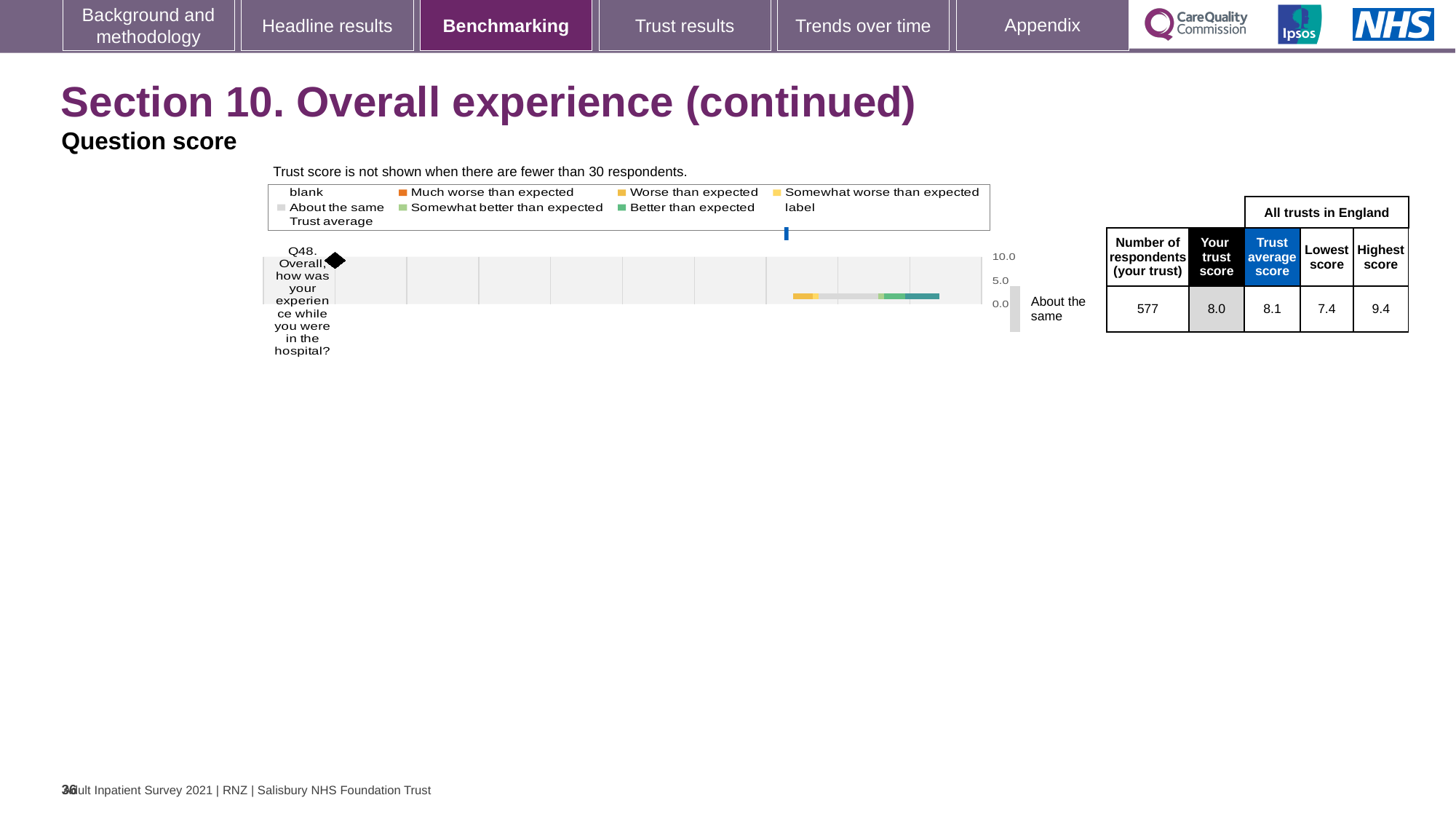
What is the trust's score for Q48 as shown in the table next to the chart? 8.0 Which question is plotted in the chart? Q48. Overall, how was your experience while you were in the hospital? What is the highest value shown on the chart's axis? 10.0 What is the lowest score among all trusts in England for Q48? 7.4 How many respondents from the trust answered Q48? 577 What is the trust average score for Q48 across all trusts in England? 8.1 What is the highest score among all trusts in England for Q48? 9.4 What is the difference between the highest score (9.4) and the lowest score (7.4) for Q48? 2.0 Is the trust's score for Q48 greater or less than 5.0 on the chart axis? greater What kind of chart is shown on the slide? bar chart How many questions (categories) are plotted in the chart? 1 Which benchmark category is the trust's result for Q48 placed in? About the same